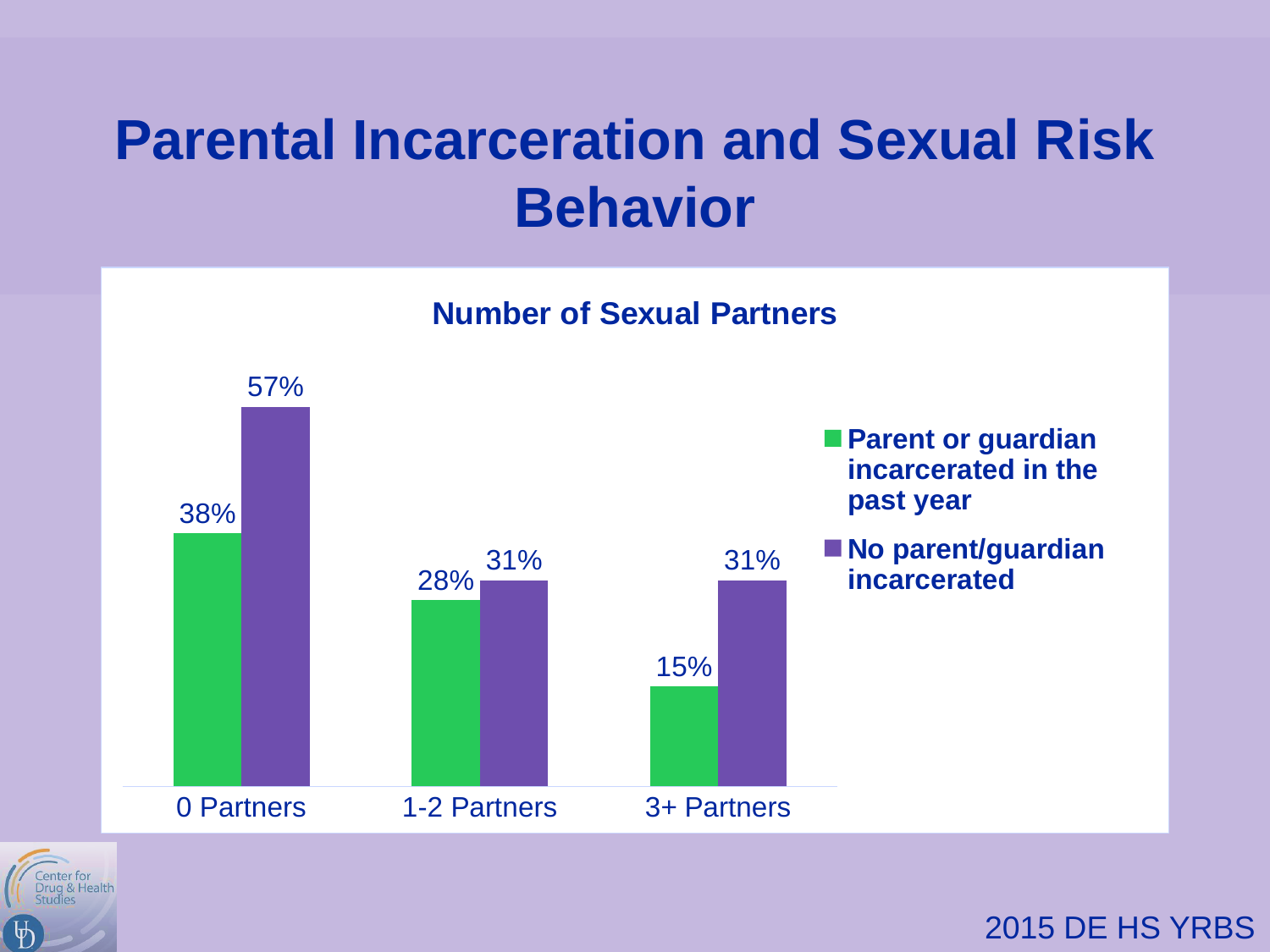
What is the difference between the two series for 0 Partners? 19% How many categories are shown on the x axis? 3 What is the value for 0 Partners in the 'No parent/guardian incarcerated' series? 57% What kind of chart is shown on the slide? Bar chart For 1-2 Partners, which series has the larger value? No parent/guardian incarcerated What is the value for 3+ Partners in the 'Parent or guardian incarcerated in the past year' series? 15% What is the difference between the two series for 3+ Partners? 16% What is the value for 1-2 Partners in the 'No parent/guardian incarcerated' series? 31% What is the value for 0 Partners in the 'Parent or guardian incarcerated in the past year' series? 38% How many series does the legend list? 2 Which category has the lowest value in the 'Parent or guardian incarcerated in the past year' series? 3+ Partners Which category has the highest value in the 'No parent/guardian incarcerated' series? 0 Partners